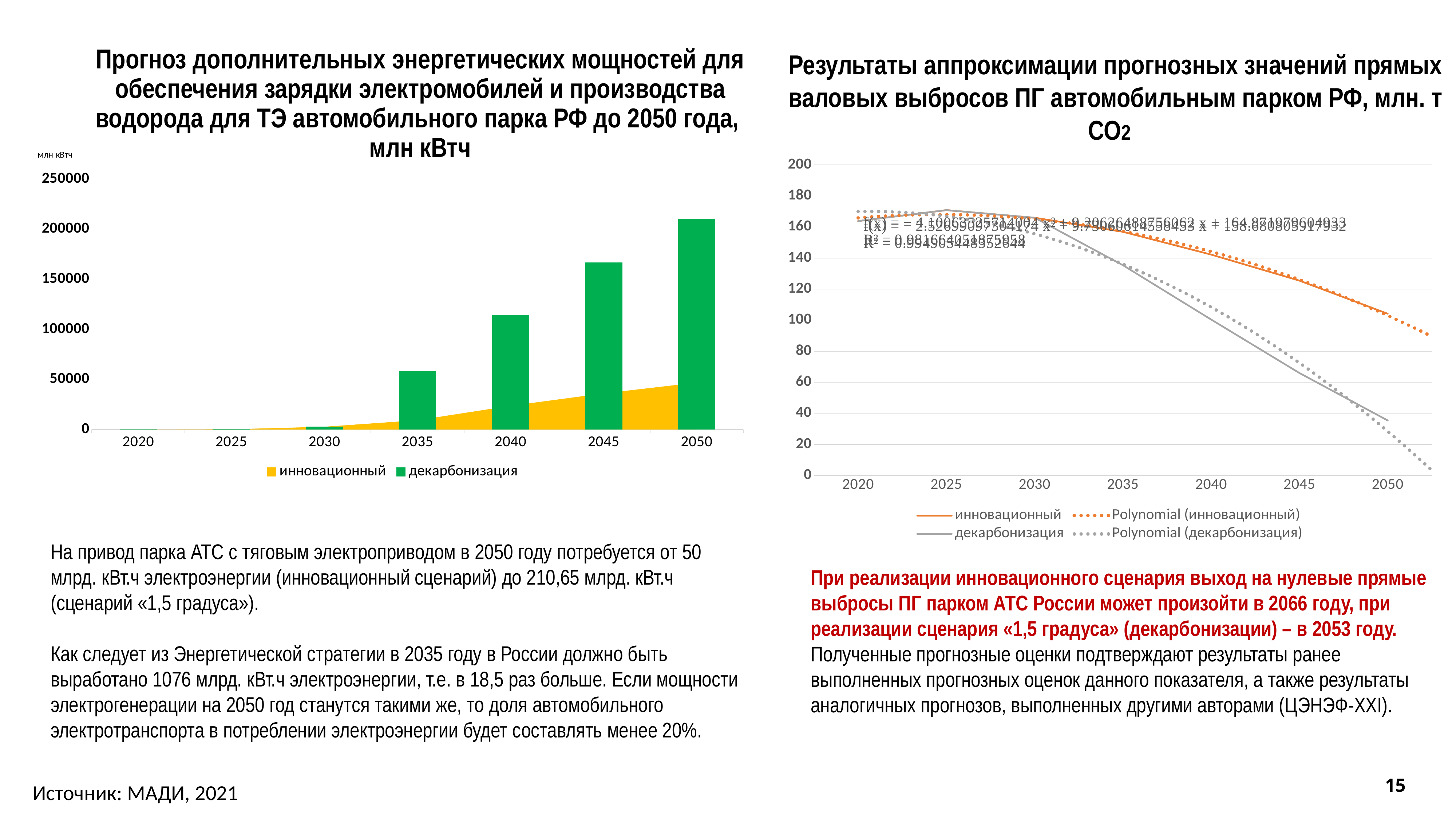
On the left chart, is the декарбонизация value for 2040 greater or less than 100000? greater On the left chart, is the декарбонизация value for 2045 greater or less than 200000? less On the left chart, how many years are labelled on the x axis? 7 On the left chart, how many series does the legend list? 2 On the right chart, how many entries does the legend list? 4 On the right chart, what kind of chart is it? line chart On the left chart, is the декарбонизация value for 2050 greater or less than 200000? greater On the left chart, which year has the tallest декарбонизация bar? 2050 On the right chart, do the декарбонизация values rise or fall from 2030 to 2050? fall On the left chart, what kind of chart is used to show the декарбонизация series? bar chart On the left chart, do the декарбонизация values rise or fall from 2020 to 2050? rise On the right chart, in 2045 which series is higher, инновационный or декарбонизация? инновационный